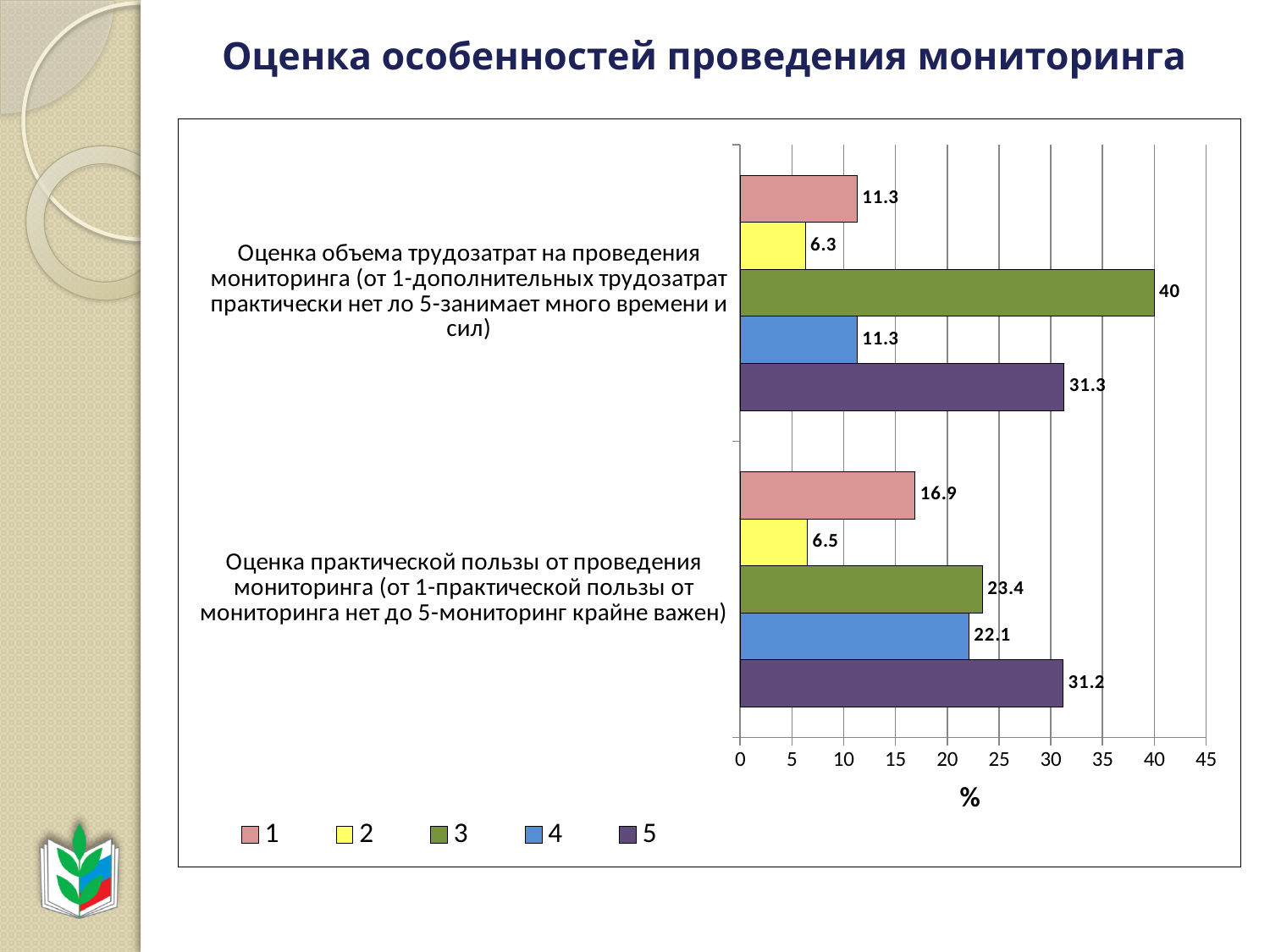
What is the value for series 5 in the category "Оценка практической пользы от проведения мониторинга"? 31.2 What is the value for series 3 in the category "Оценка объема трудозатрат на проведения мониторинга"? 40 Which is larger in the category "Оценка практической пользы от проведения мониторинга": series 3 or series 4? series 3 What is the difference between series 3 and series 5 in the category "Оценка объема трудозатрат на проведения мониторинга"? 8.7 How many categories are shown on the chart? 2 What is the difference between series 1 and series 2 in the category "Оценка практической пользы от проведения мониторинга"? 10.4 What type of chart is shown on the slide? bar chart What is the value for series 2 in the category "Оценка объема трудозатрат на проведения мониторинга"? 6.3 What unit is shown on the horizontal axis label? % Which series has the lowest value in the category "Оценка объема трудозатрат на проведения мониторинга"? 2 Which series has the highest value in the category "Оценка практической пользы от проведения мониторинга"? 5 How many series does the legend list? 5